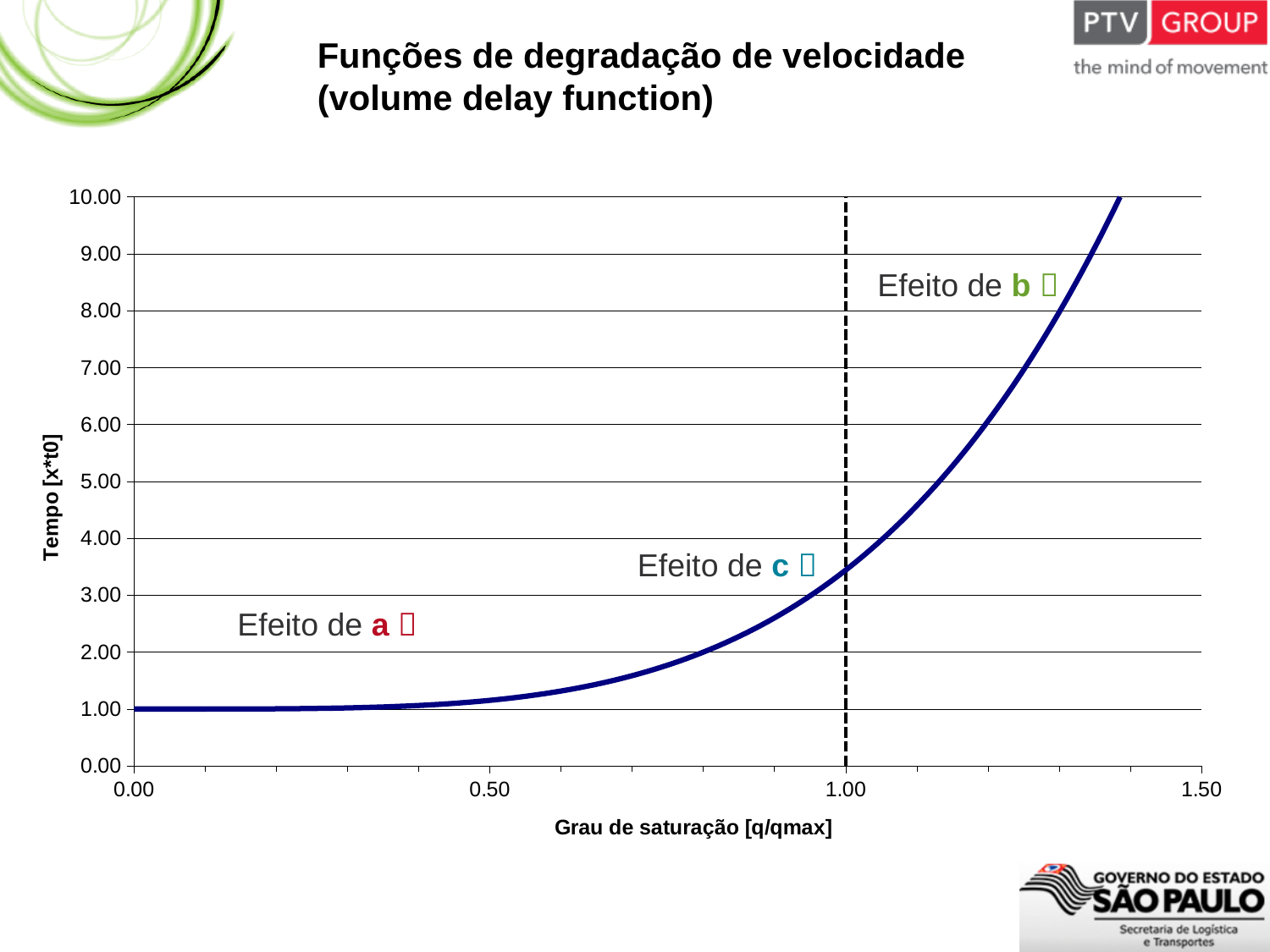
What is the label of the x axis? Grau de saturação [q/qmax] Does the plotted curve rise or fall as the degree of saturation (Grau de saturação) increases? rises Is the value of the curve at a Grau de saturação of 0.50 greater or less than 2.00? less Is the value of the curve at a Grau de saturação of 1.00 greater or less than 3.00? greater What kind of chart is shown on the slide? line chart At which x-axis value is the dashed vertical line drawn? 1.00 Is the value of the curve at a Grau de saturação of 0.75 greater or less than 3.00? less What is the value of Tempo [x*t0] at a Grau de saturação of 0.00? 1.00 Which is larger: the curve's value at a Grau de saturação of 0.50 or at 1.00? 1.00